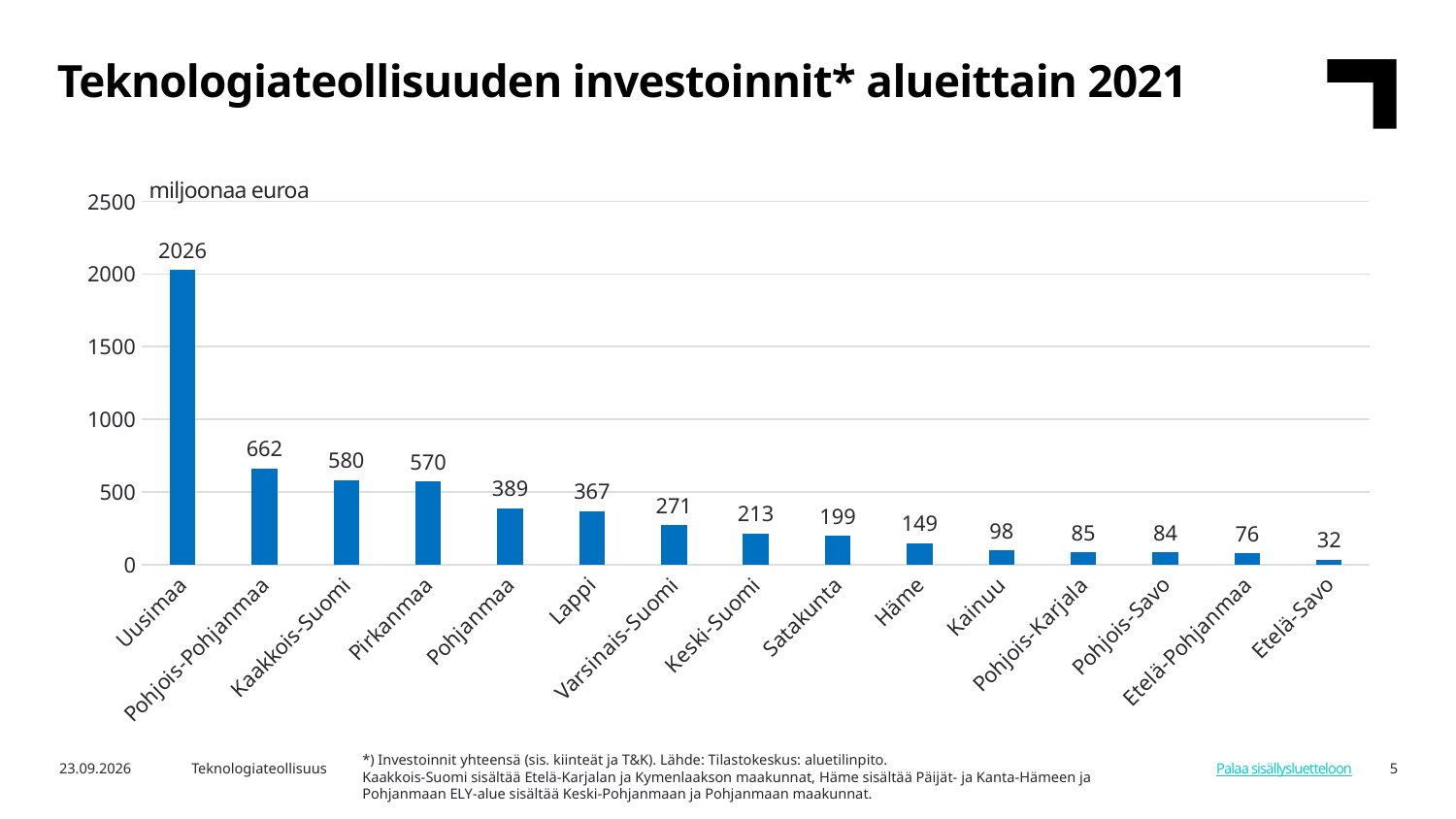
What unit is shown above the y axis of the chart? miljoonaa euroa What is the value for Pirkanmaa? 570 Do the values rise or fall from left to right along the x axis? fall What kind of chart is shown on the slide? bar chart What is the value for Häme? 149 How many regions are shown on the chart? 15 Which region has the highest value? Uusimaa Which is larger, the value for Lappi or the value for Pohjanmaa? Pohjanmaa Is the value for Varsinais-Suomi greater or less than 500? less What is the value for Uusimaa? 2026 Which region has the lowest value? Etelä-Savo What is the difference between the values for Pohjois-Pohjanmaa and Kaakkois-Suomi? 82